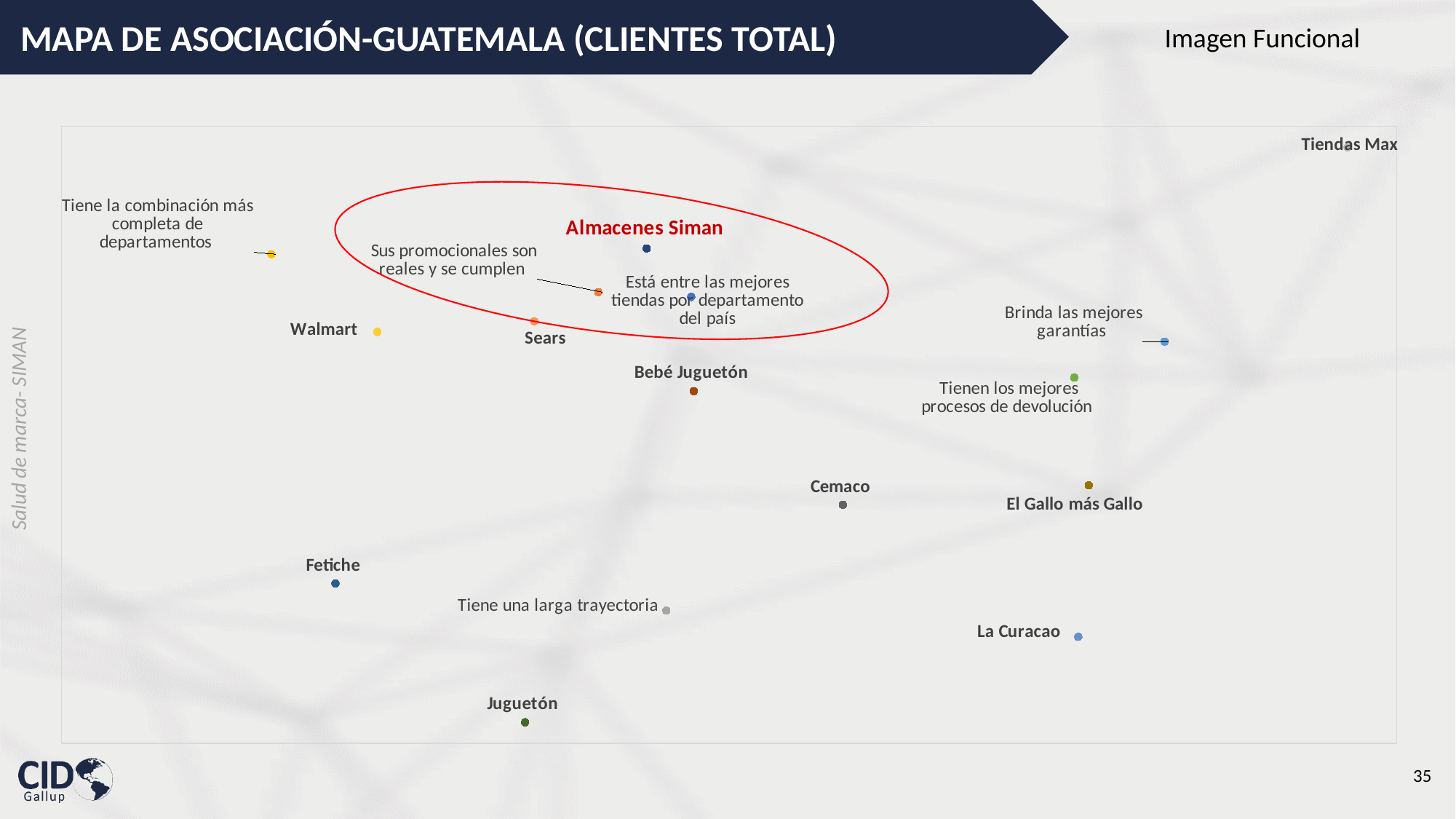
How many attribute statements are plotted on the chart? 6 Which attribute statement is positioned furthest to the left on the chart? Tiene la combinación más completa de departamentos Which brand is highlighted with a red ellipse on the chart? Almacenes Siman What is the title of the chart on the slide? MAPA DE ASOCIACIÓN-GUATEMALA (CLIENTES TOTAL) How many brand names are labeled on the chart? 10 Which attribute statement is positioned furthest to the right on the chart? Brinda las mejores garantías Which is positioned further to the left on the chart, Walmart or Sears? Walmart Which brand is positioned lowest on the chart? Juguetón Which is positioned lower on the chart, La Curacao or Cemaco? La Curacao What kind of chart is shown on the slide? scatter chart Which brand is positioned furthest to the left on the chart? Fetiche Which is positioned higher on the chart, Cemaco or El Gallo más Gallo? El Gallo más Gallo